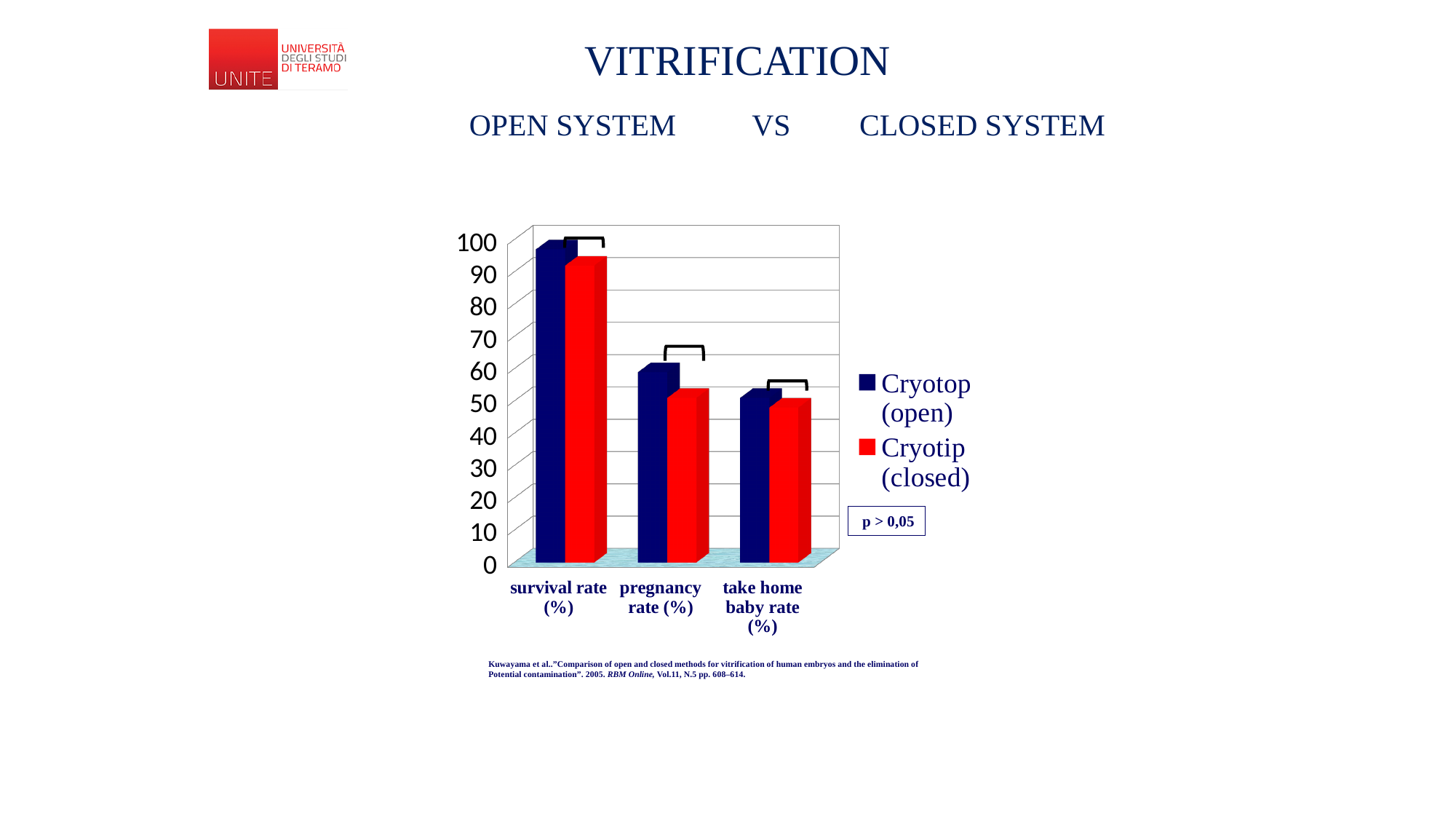
Which category has the lowest value for the Cryotip (closed) series? take home baby rate (%) How many series does the chart's legend list? 2 Is the Cryotop (open) value for survival rate (%) greater or less than 90? greater Do the Cryotop (open) values rise or fall from left to right across the categories? fall Which category has the highest value for the Cryotop (open) series? survival rate (%) What colour represents the Cryotip (closed) series in the chart? red What kind of chart is shown on the slide? bar chart How many categories are shown on the x axis of the chart? 3 Is the Cryotop (open) value for pregnancy rate (%) greater or less than 70? less Is the Cryotip (closed) value for take home baby rate (%) greater or less than 60? less For survival rate (%), which series has the larger value, Cryotop (open) or Cryotip (closed)? Cryotop (open) For pregnancy rate (%), which series has the larger value, Cryotop (open) or Cryotip (closed)? Cryotop (open)